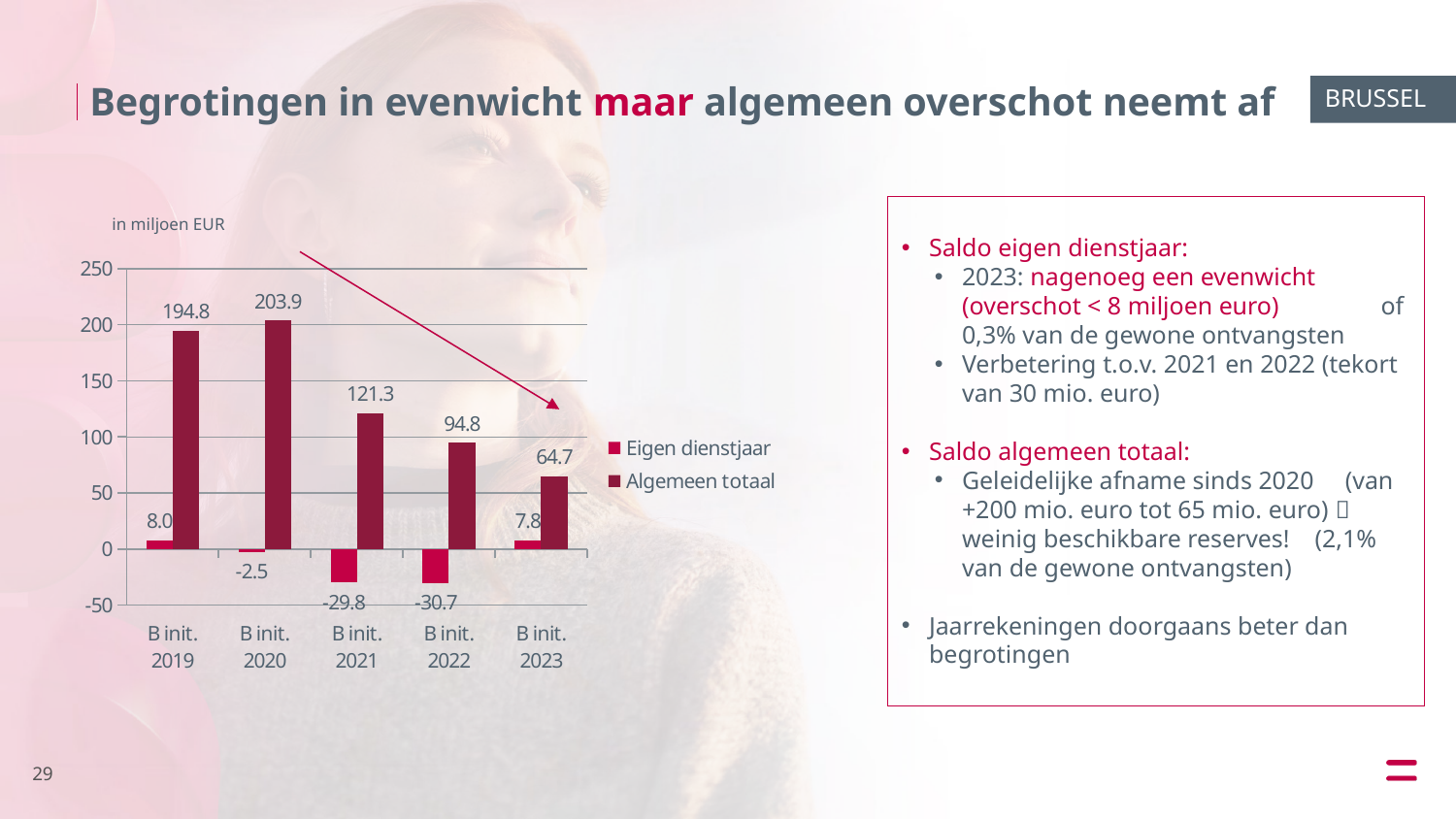
In which year is Algemeen totaal the highest? B init. 2020 What kind of chart is shown on the slide? Bar chart How many years are shown on the x axis? 5 How many series does the legend list? 2 Does Algemeen totaal rise or fall from B init. 2020 to B init. 2023? Fall What is the value of Algemeen totaal for B init. 2023? 64.7 What is the difference between Algemeen totaal in B init. 2019 and B init. 2023? 130.1 What is the value of Eigen dienstjaar for B init. 2019? 8.0 What is the value of Eigen dienstjaar for B init. 2022? -30.7 What is the value of Algemeen totaal for B init. 2020? 203.9 Which is larger: Algemeen totaal in B init. 2021 or in B init. 2022? B init. 2021 In which year is Eigen dienstjaar the lowest? B init. 2022